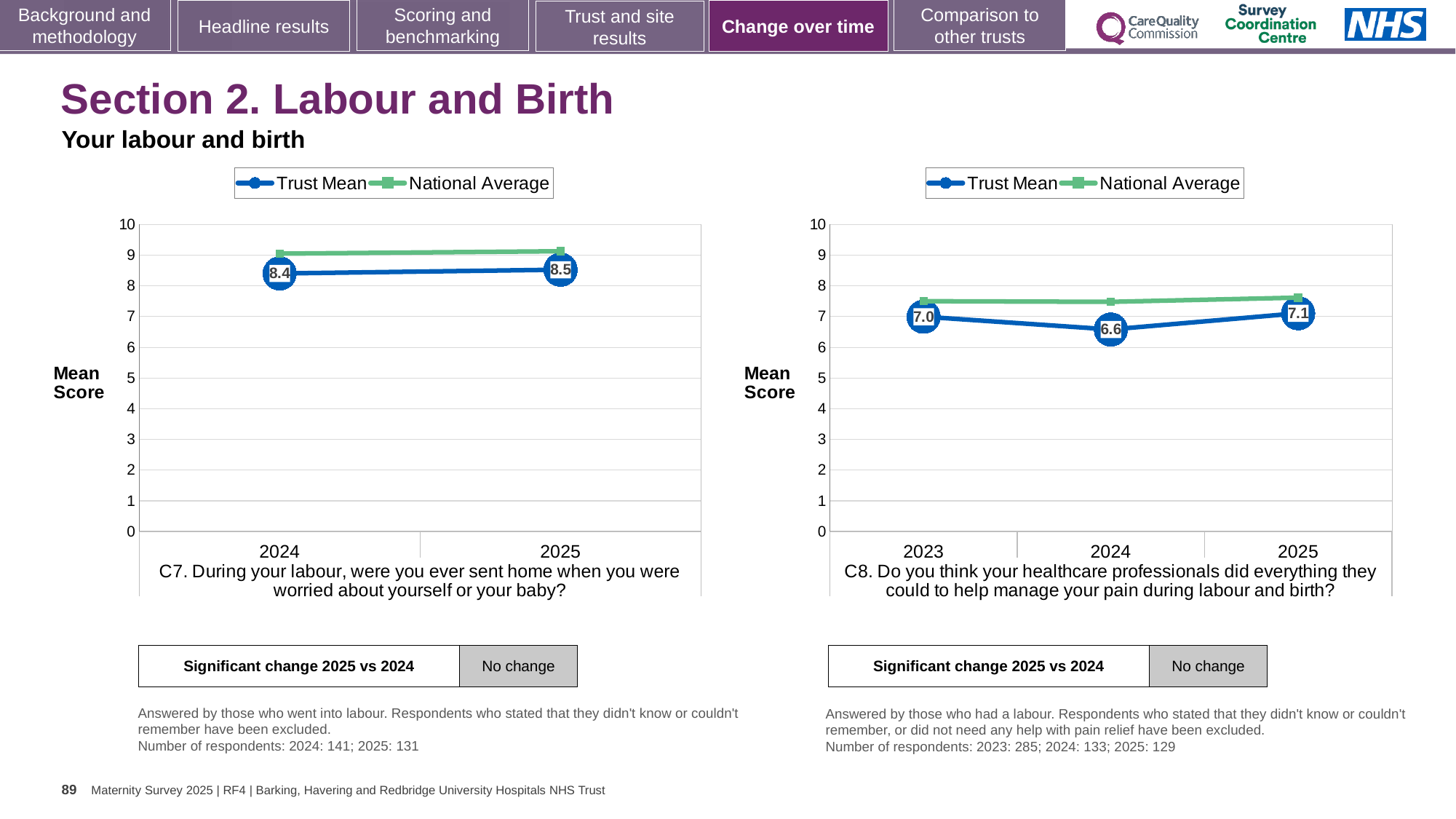
In the right chart (C8), what is the Trust Mean for 2025? 7.1 In the right chart (C8), what is the difference between the Trust Mean for 2025 and 2024? 0.5 In the right chart (C8), is the National Average for 2023 greater or less than 8? less In the right chart (C8), what is the Trust Mean for 2024? 6.6 How many series does the legend of the left chart (C7) list? 2 In the right chart (C8), which year has the lowest Trust Mean? 2024 How many years are plotted on the x axis of the right chart (C8)? 3 In the left chart (C7), what is the Trust Mean for 2025? 8.5 What kind of chart is the left chart (C7)? Line chart In the left chart (C7), what is the Trust Mean for 2024? 8.4 In the right chart (C8), which year has the highest Trust Mean? 2025 In the left chart (C7), is the National Average for 2025 greater or less than 8? greater